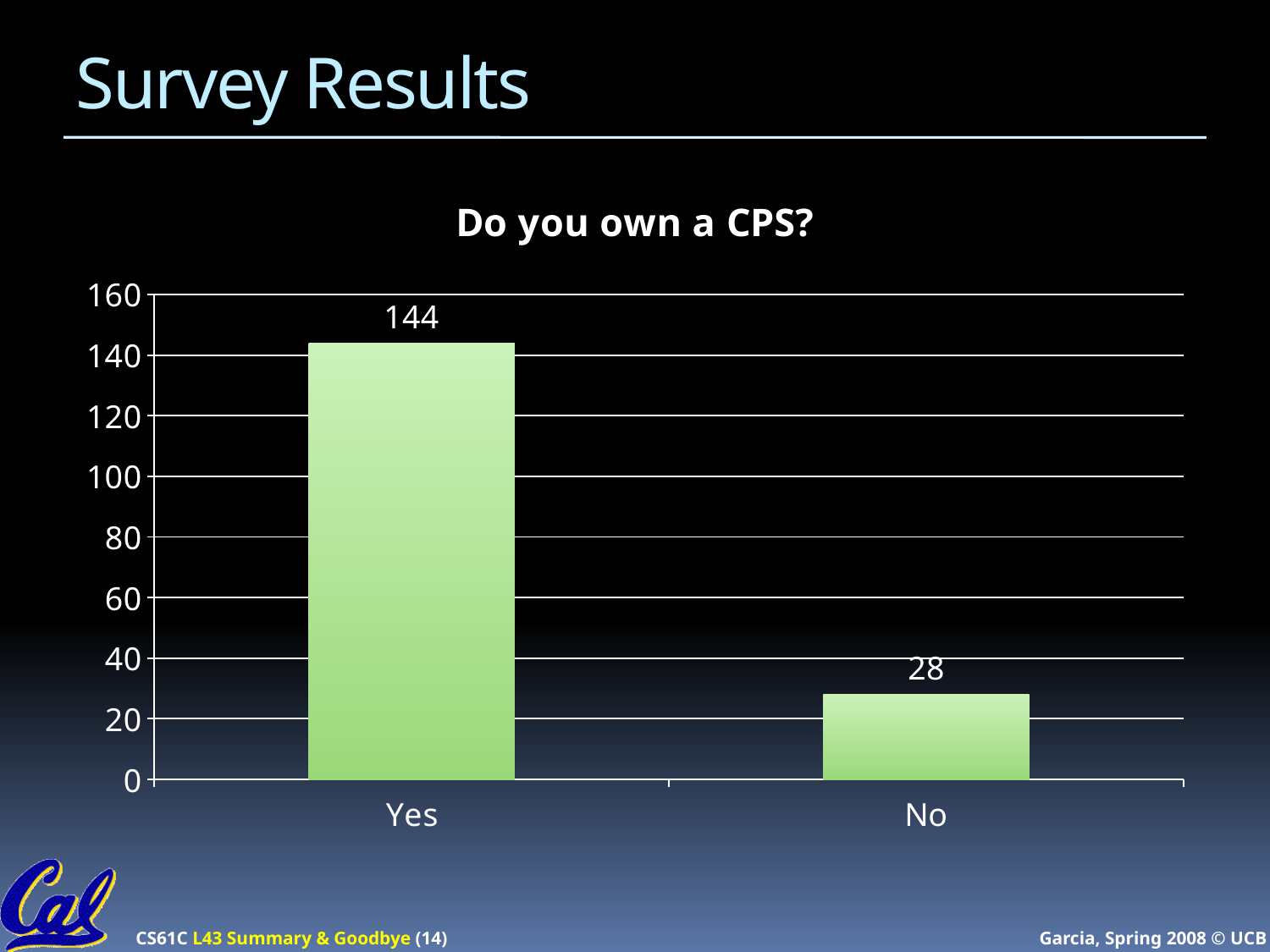
Which category has the highest value? Yes What kind of chart is shown on the slide? bar chart Which is larger, the value for Yes or the value for No? Yes Is the value for No greater or less than 40? less What is the difference between the values for Yes and No? 116 Which category has the lowest value? No What is the value for No? 28 What is the title of the chart? Do you own a CPS? Is the value for Yes greater or less than 140? greater What is the highest value shown on the y axis? 160 What is the value for Yes? 144 How many categories are shown on the x axis? 2